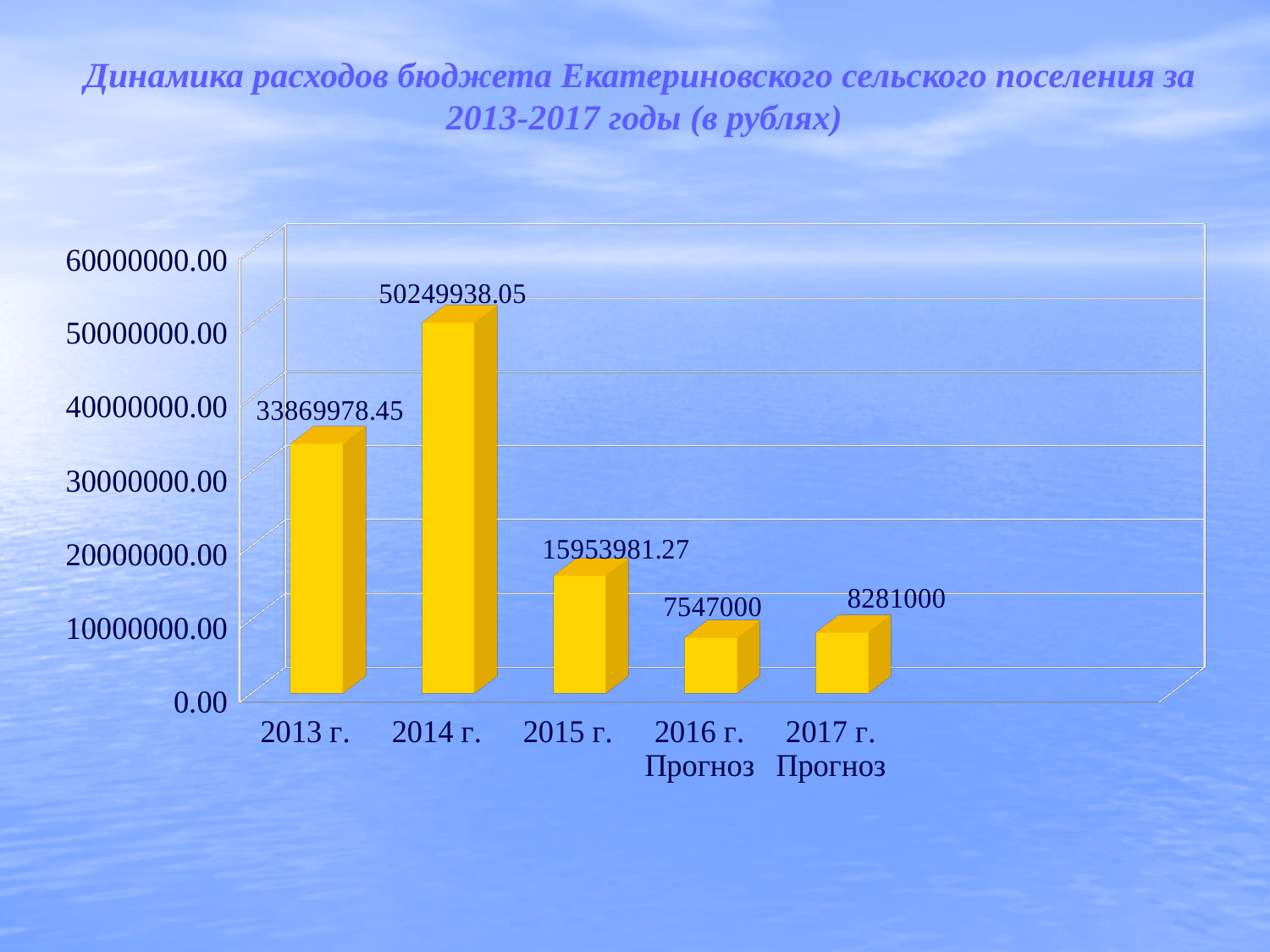
What is the value for 2017 г. Прогноз? 8281000 What is the difference between the values for 2014 г. and 2013 г.? 16379959.60 What is the difference between the values for 2017 г. Прогноз and 2016 г. Прогноз? 734000 Which is larger, the value for 2015 г. or the value for 2017 г. Прогноз? 2015 г. Which category has the lowest value? 2016 г. Прогноз What is the value for 2013 г.? 33869978.45 Is the value for 2015 г. greater or less than 20000000.00? less How many categories are shown on the x axis? 5 What is the value for 2016 г. Прогноз? 7547000 What is the value for 2014 г.? 50249938.05 What kind of chart is shown on the slide? bar chart Which year has the highest value? 2014 г.